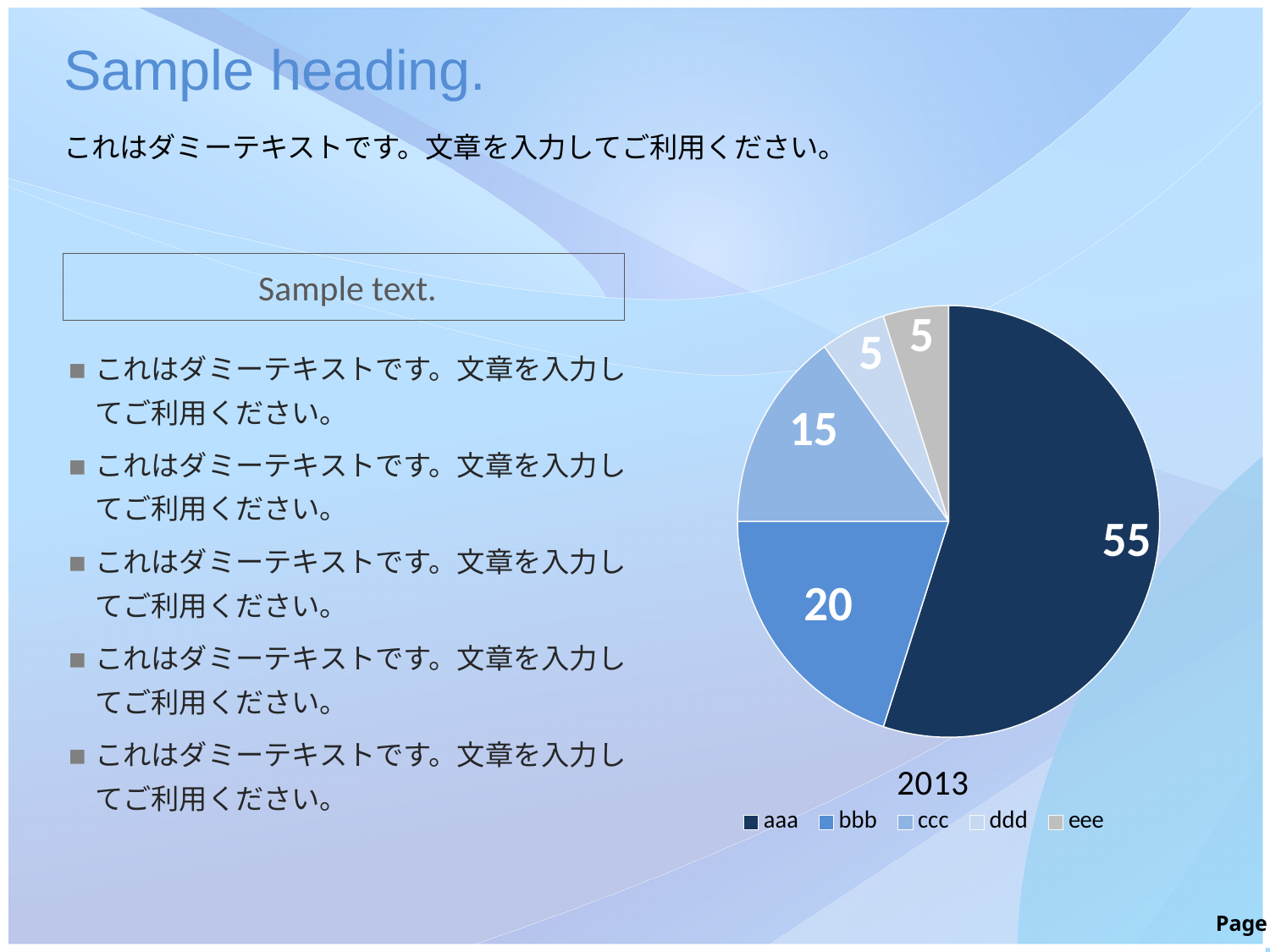
How many entries does the legend list? 5 What is the value for bbb in the pie chart? 20 Which is larger, the value for bbb or the value for ccc? bbb What is the title of the pie chart? 2013 What share of the pie does aaa represent? 55% Which category has the largest slice in the pie chart? aaa What is the value for ccc in the pie chart? 15 What type of chart is shown on the slide? pie chart What is the difference between the values for aaa and bbb? 35 What is the value for ddd in the pie chart? 5 How many slices does the pie chart have? 5 What is the value for aaa in the pie chart? 55